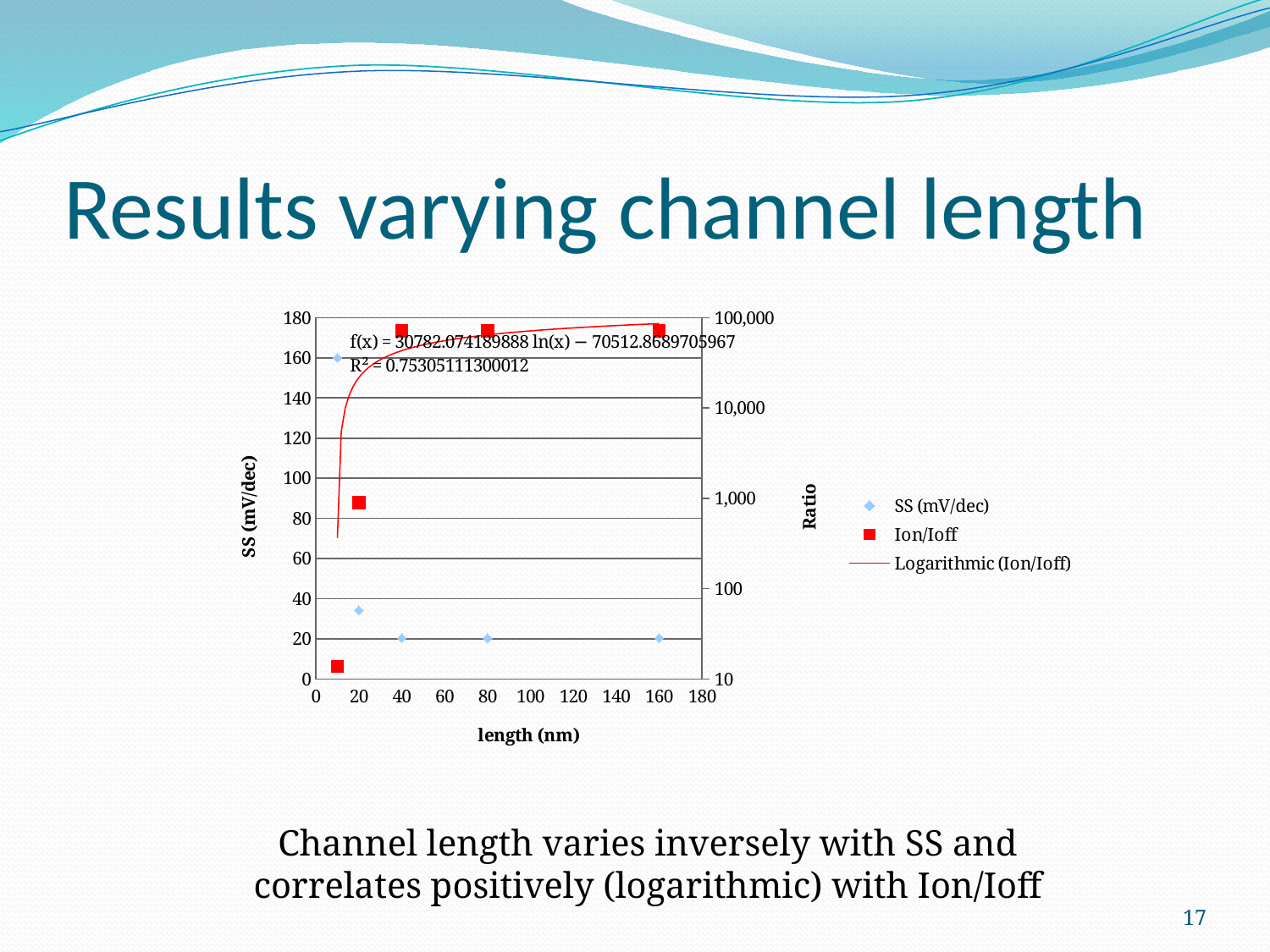
What kind of chart is shown on the slide? scatter chart Which has the larger SS (mV/dec) value: the point at 10 nm or the point at 20 nm? 10 nm Is the SS (mV/dec) value at a channel length of 160 nm greater or less than 40? less At which channel length is the SS (mV/dec) value highest? 10 nm Is the SS (mV/dec) value at a channel length of 10 nm greater or less than 140? greater How many data points are plotted for the SS (mV/dec) series? 5 Do the Ion/Ioff values rise or fall as channel length increases along the x axis? rise Is the Ion/Ioff value at a channel length of 40 nm greater or less than 10,000? greater Do the SS (mV/dec) values rise or fall as channel length increases along the x axis? fall What R² value is printed on the chart for the logarithmic trendline? 0.75305111300012 At which channel length is the Ion/Ioff value lowest? 10 nm How many series does the legend list? 3